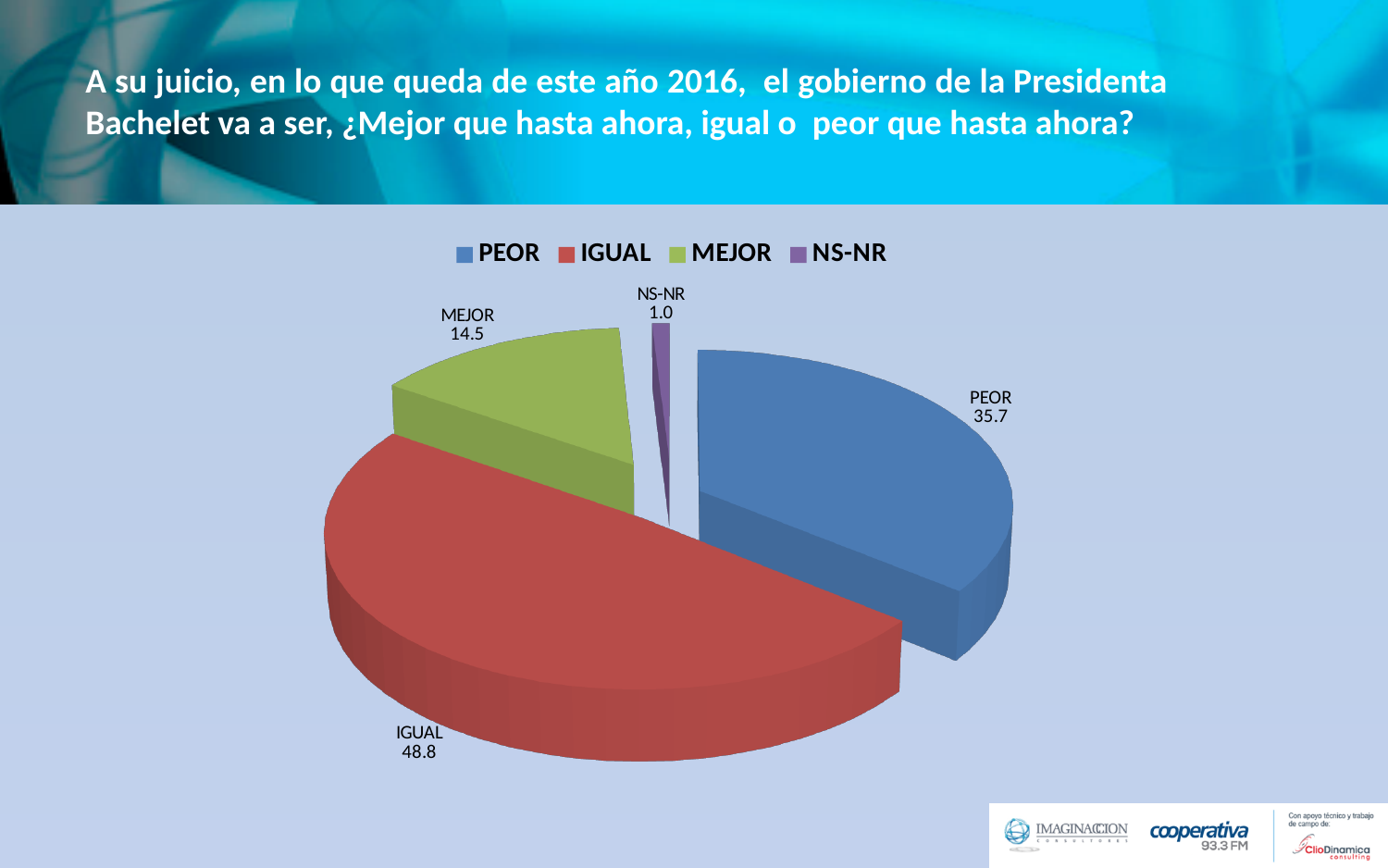
What is the value for NS-NR? 1.0 How many entries does the legend list? 4 Which category has the smallest slice? NS-NR What is the value for MEJOR? 14.5 What is the difference between the values for IGUAL and PEOR? 13.1 What is the value for PEOR? 35.7 How many categories are shown in the pie chart? 4 What kind of chart is shown on the slide? Pie chart What is the value for IGUAL? 48.8 What colour is the IGUAL slice? Red Which is larger, the value for PEOR or the value for MEJOR? PEOR Which category has the largest slice? IGUAL